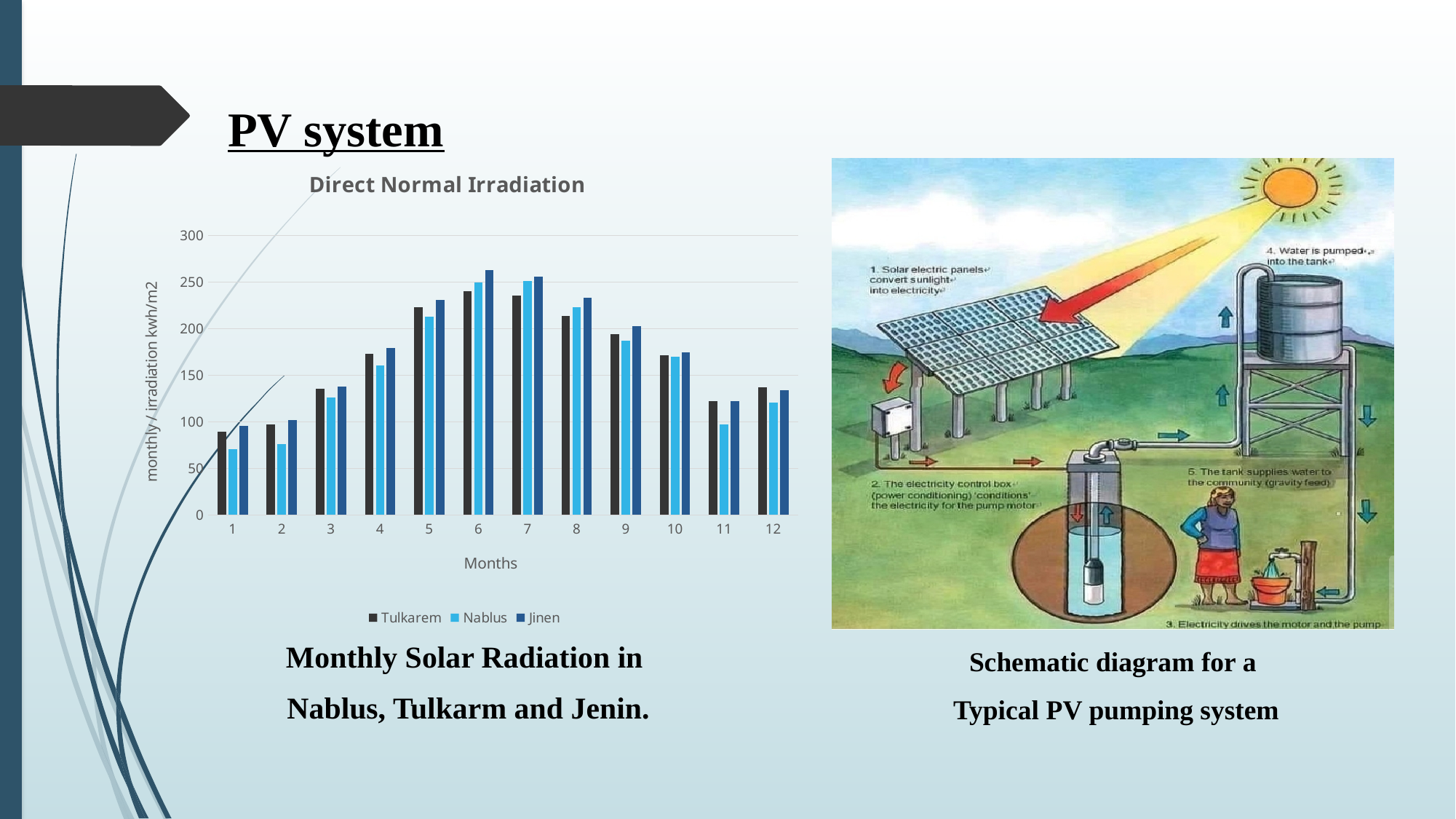
How many series does the legend of the 'Direct Normal Irradiation' chart list? 3 In the 'Direct Normal Irradiation' chart, which month has the lowest value for Nablus? 1 In the 'Direct Normal Irradiation' chart, is the value for Nablus in month 1 greater or less than 100? less How many months are shown on the x axis of the 'Direct Normal Irradiation' chart? 12 In the 'Direct Normal Irradiation' chart, do the values for Jinen rise or fall from month 1 to month 6? rise In the 'Direct Normal Irradiation' chart, which is larger in month 6: Jinen or Tulkarem? Jinen What is the y-axis label of the 'Direct Normal Irradiation' chart? monthly / irradiation kwh/m2 In the 'Direct Normal Irradiation' chart, which month has the highest value for Jinen? 6 In the 'Direct Normal Irradiation' chart, which is larger in month 11: Tulkarem or Nablus? Tulkarem In the 'Direct Normal Irradiation' chart, is the value for Tulkarem in month 11 greater or less than 150? less What type of chart is shown under the title 'Direct Normal Irradiation'? bar chart In the 'Direct Normal Irradiation' chart, is the value for Jinen in month 6 greater or less than 250? greater